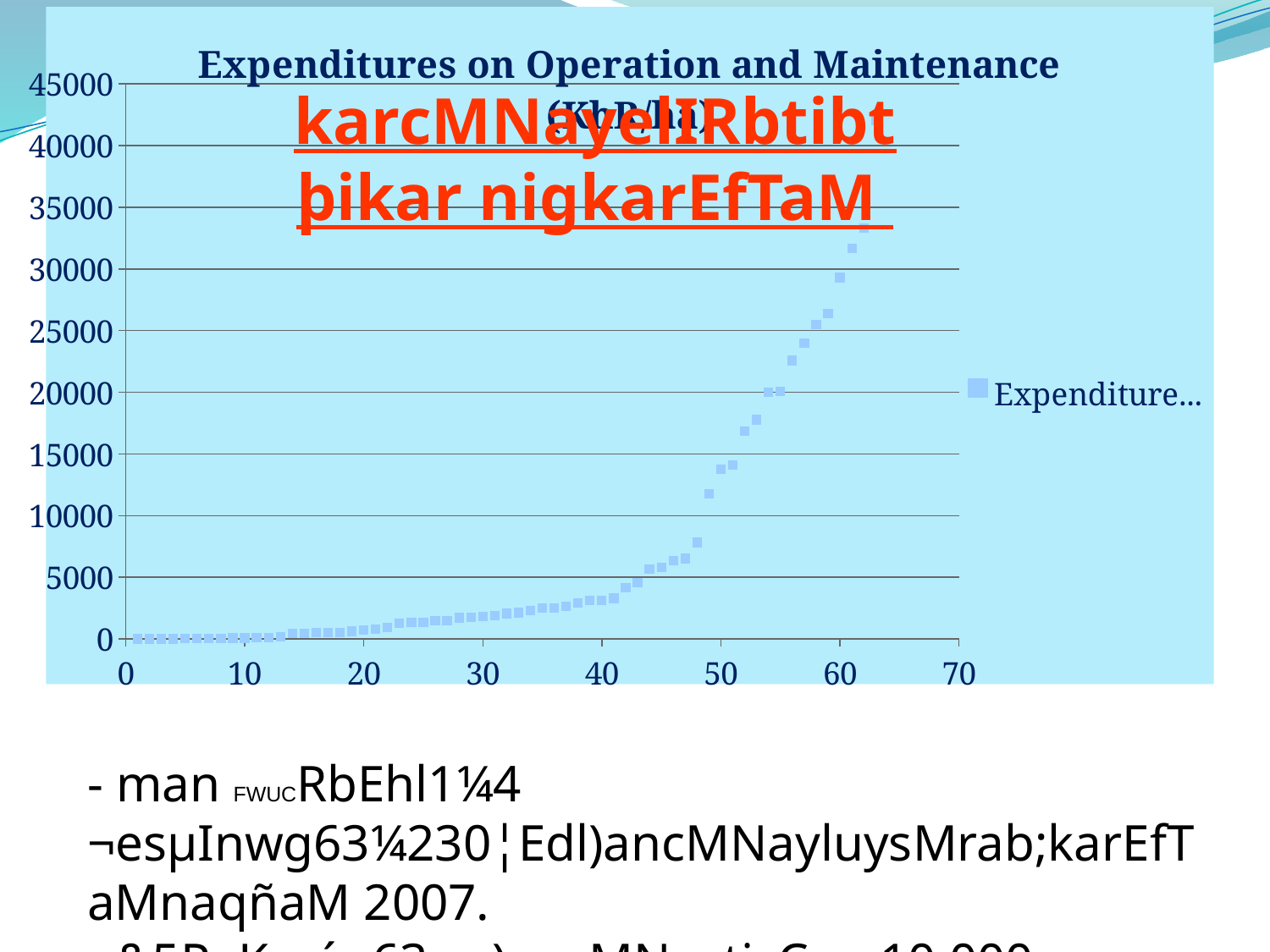
What is the title of the chart? Expenditures on Operation and Maintenance (KhR/ha) Is the plotted value at x = 30 greater or less than 5000? less What is the highest value shown on the y-axis? 45000 Is the plotted value at x = 10 greater or less than 5000? less Do the plotted values rise or fall as the x-axis value increases? rise Are the plotted values at the left end of the x-axis (near x = 0) greater or less than 5000? less How many series does the chart's legend list? 1 What kind of chart is shown on the slide? scatter chart Which is larger, the plotted value at x = 20 or the plotted value at x = 60? x = 60